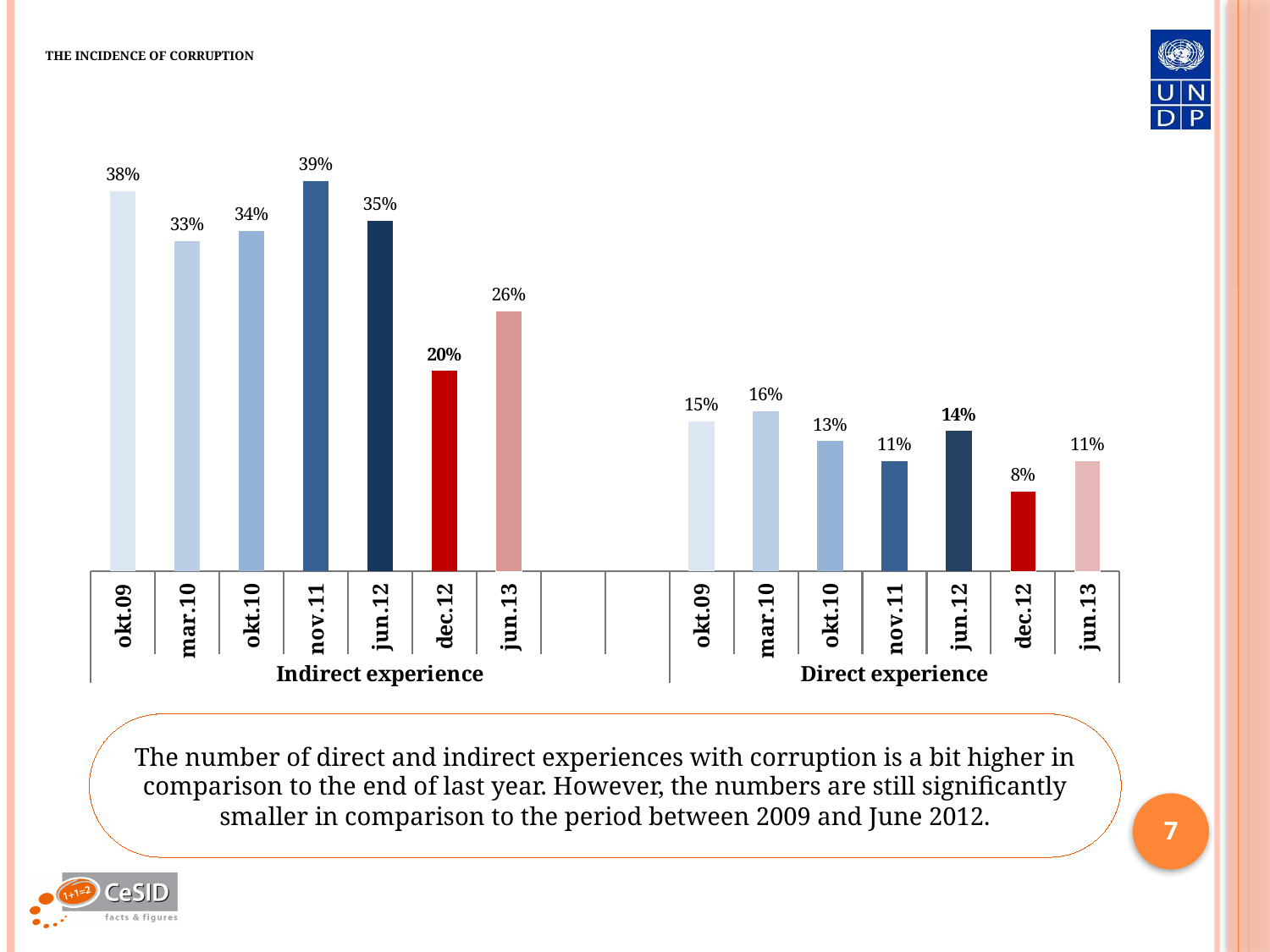
What are the two groups labelled beneath the x axis? Indirect experience and Direct experience How many periods are shown in the Direct experience group? 7 What is the value for jun.13 in the Indirect experience group? 26% What is the difference between the Indirect experience values for jun.13 and dec.12? 6% Which period has the lowest value in the Indirect experience group? dec.12 What kind of chart is shown on the slide? Bar chart What is the difference between the Direct experience values for mar.10 and okt.10? 3% Which is larger: the Indirect experience value for okt.09 or for jun.12? okt.09 Which period has the lowest value in the Direct experience group? dec.12 What is the value for dec.12 in the Direct experience group? 8% What is the value for nov.11 in the Indirect experience group? 39% Which period has the highest value in the Indirect experience group? nov.11